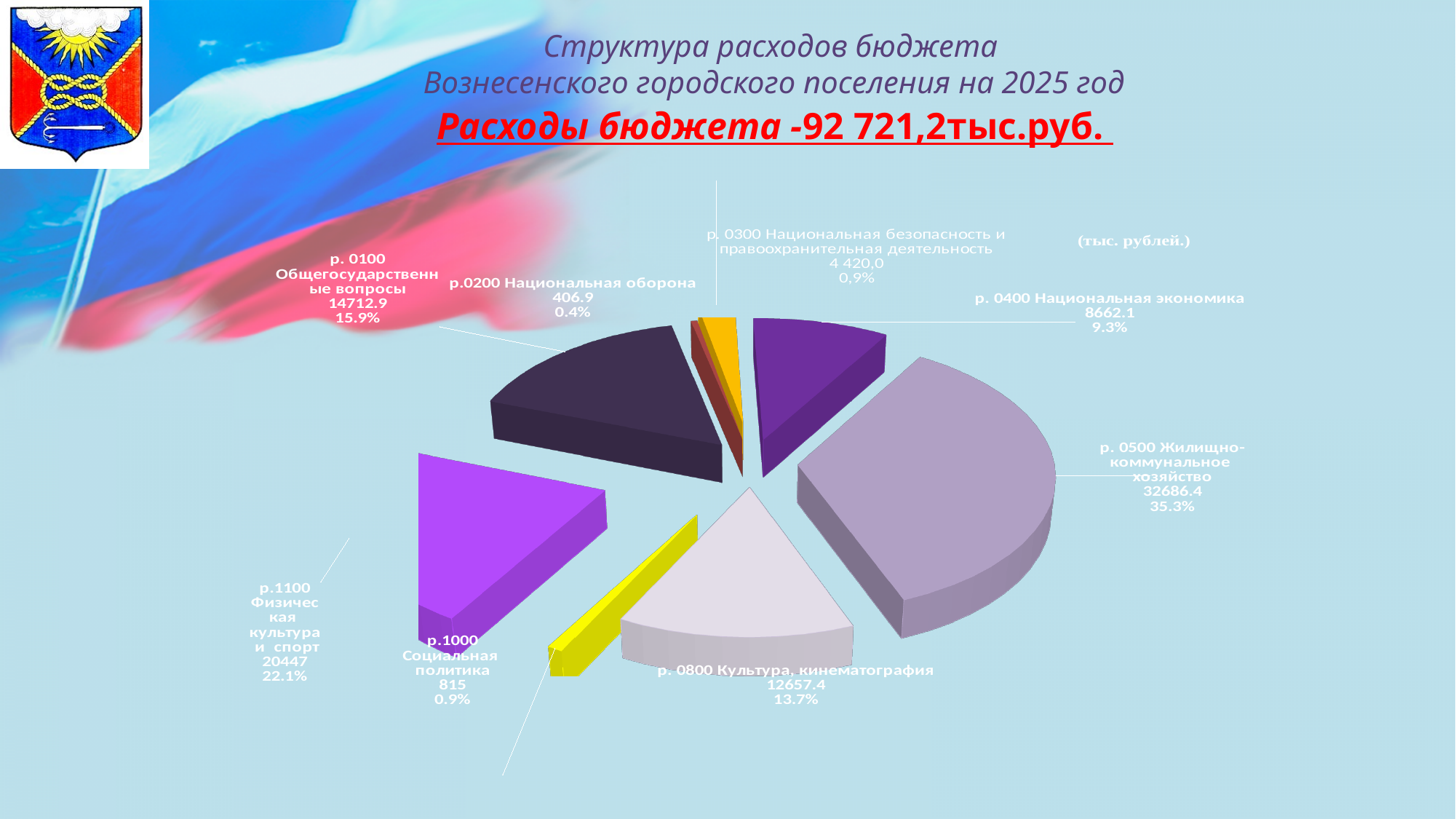
What share of the pie does р.1100 Физическая культура и спорт represent? 22.1% What is the value for р. 0100 Общегосударственные вопросы? 14712.9 What is the value for р.1000 Социальная политика? 815 How many categories (slices) does the pie chart show? 8 What is the difference between the values for р. 0500 Жилищно-коммунальное хозяйство and р.1100 Физическая культура и спорт? 12239.4 Which is larger, the value for р. 0400 Национальная экономика or р. 0800 Культура, кинематография? р. 0800 Культура, кинематография What is the value for р. 0500 Жилищно-коммунальное хозяйство? 32686.4 What total budget expenditure is stated in the slide title? 92 721,2 тыс.руб. Which category has the smallest slice of the pie? р.0200 Национальная оборона Which category has the largest slice of the pie? р. 0500 Жилищно-коммунальное хозяйство What type of chart is shown on the slide? Pie chart What share of the pie does р. 0800 Культура, кинематография represent? 13.7%